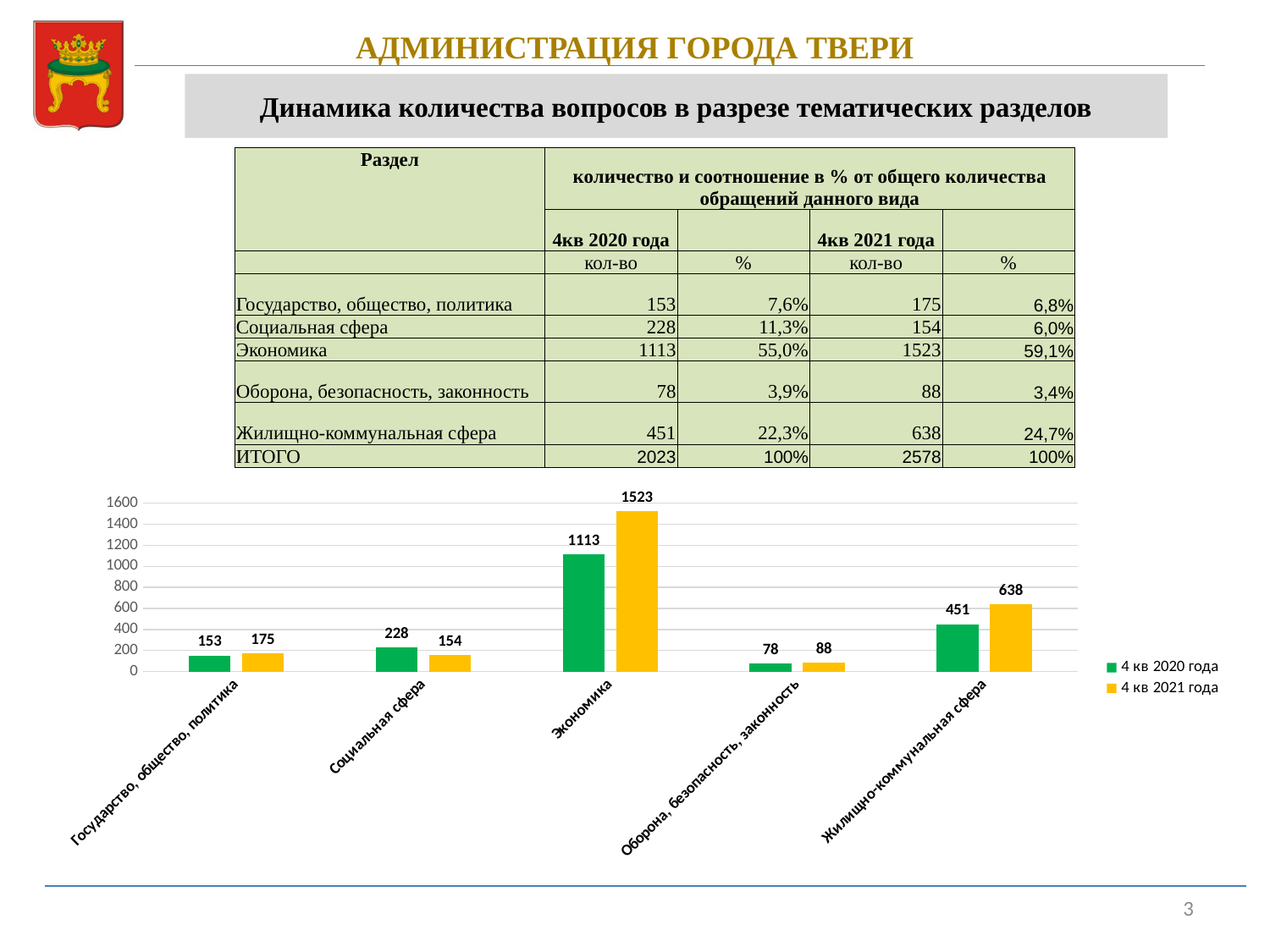
How many categories are shown on the x axis of the chart? 5 What colour are the bars for the 4 кв 2021 года series? yellow What is the value for Экономика in the 4 кв 2021 года series? 1523 What kind of chart is shown on the slide? bar chart Which category has the lowest value in the 4 кв 2021 года series? Оборона, безопасность, законность Which category has the highest value in the 4 кв 2020 года series? Экономика What is the value for Жилищно-коммунальная сфера in the 4 кв 2020 года series? 451 Which is larger for Социальная сфера: the 4 кв 2020 года value or the 4 кв 2021 года value? 4 кв 2020 года What is the difference between the 4 кв 2021 года and 4 кв 2020 года values for Экономика? 410 How many series does the chart legend list? 2 Is the value for Жилищно-коммунальная сфера in the 4 кв 2021 года series greater or less than 600? greater What is the difference between the 4 кв 2021 года and 4 кв 2020 года values for Оборона, безопасность, законность? 10